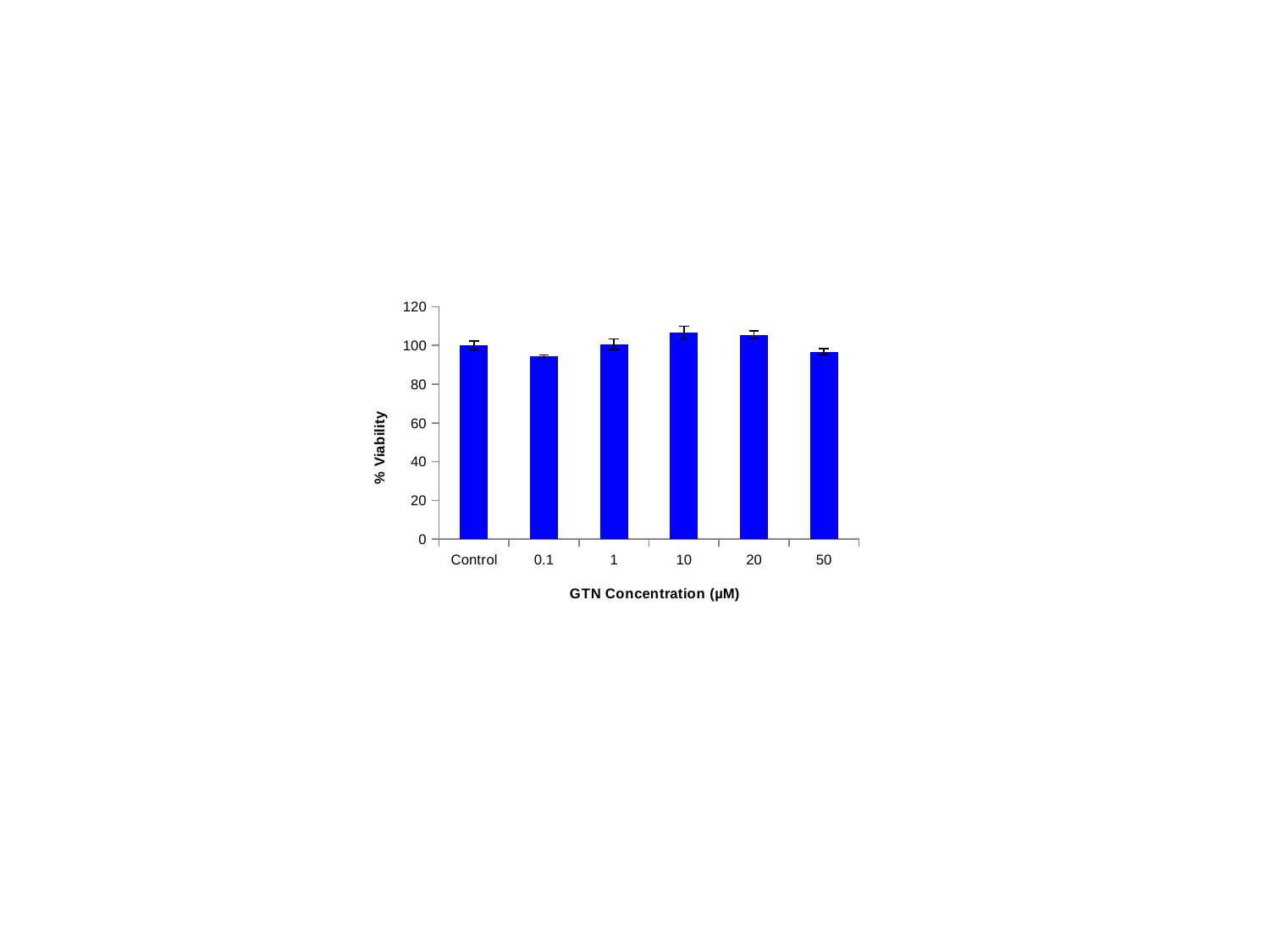
How many GTN concentration categories are plotted on the chart? 6 What is the title of the x axis? GTN Concentration (µM) What is the title of the y axis? % Viability Which has the higher % Viability, 20 µM GTN or 50 µM GTN? 20 Is the % Viability value for 20 µM GTN greater or less than 100? greater Is the % Viability value for 50 µM GTN greater or less than 80? greater What kind of chart is shown on the slide? bar chart Is the % Viability value for 0.1 µM GTN greater or less than 100? less Which has the higher % Viability, 10 µM GTN or 0.1 µM GTN? 10 Which has the higher % Viability, 10 µM GTN or 50 µM GTN? 10